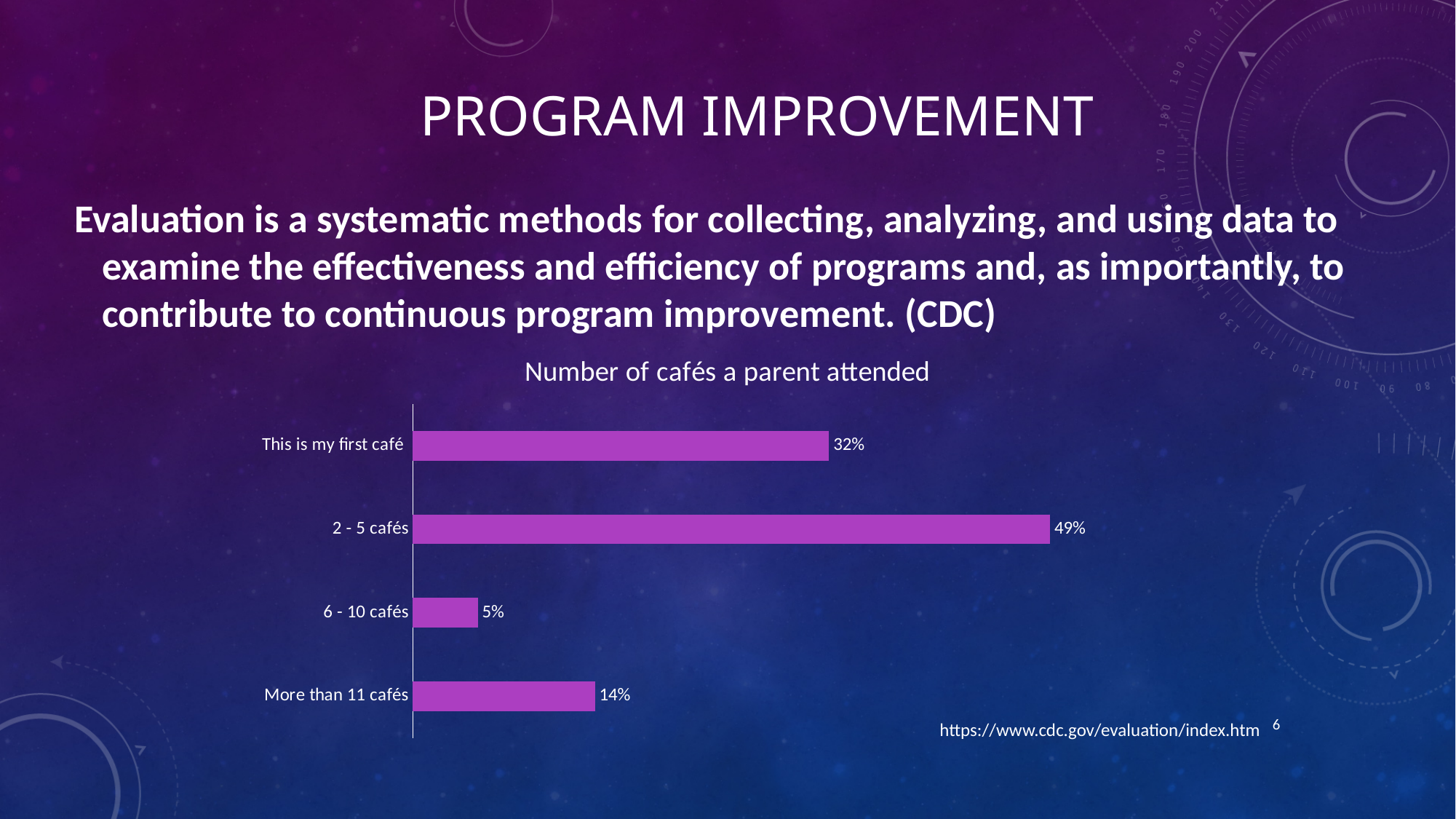
How many categories are shown in the chart? 4 Which category has the lowest value? 6 - 10 cafés Which category has the highest value? 2 - 5 cafés What is the value for 'More than 11 cafés'? 14% What is the value for the '2 - 5 cafés' category? 49% What kind of chart is shown on the slide? Bar chart What is the title of the chart? Number of cafés a parent attended Which is larger: the value for 'This is my first café' or 'More than 11 cafés'? This is my first café What is the difference between the values for '2 - 5 cafés' and 'This is my first café'? 17% What is the difference between the values for 'More than 11 cafés' and '6 - 10 cafés'? 9% What percentage of parents attended 6 - 10 cafés? 5% What percentage of parents said this is their first café? 32%